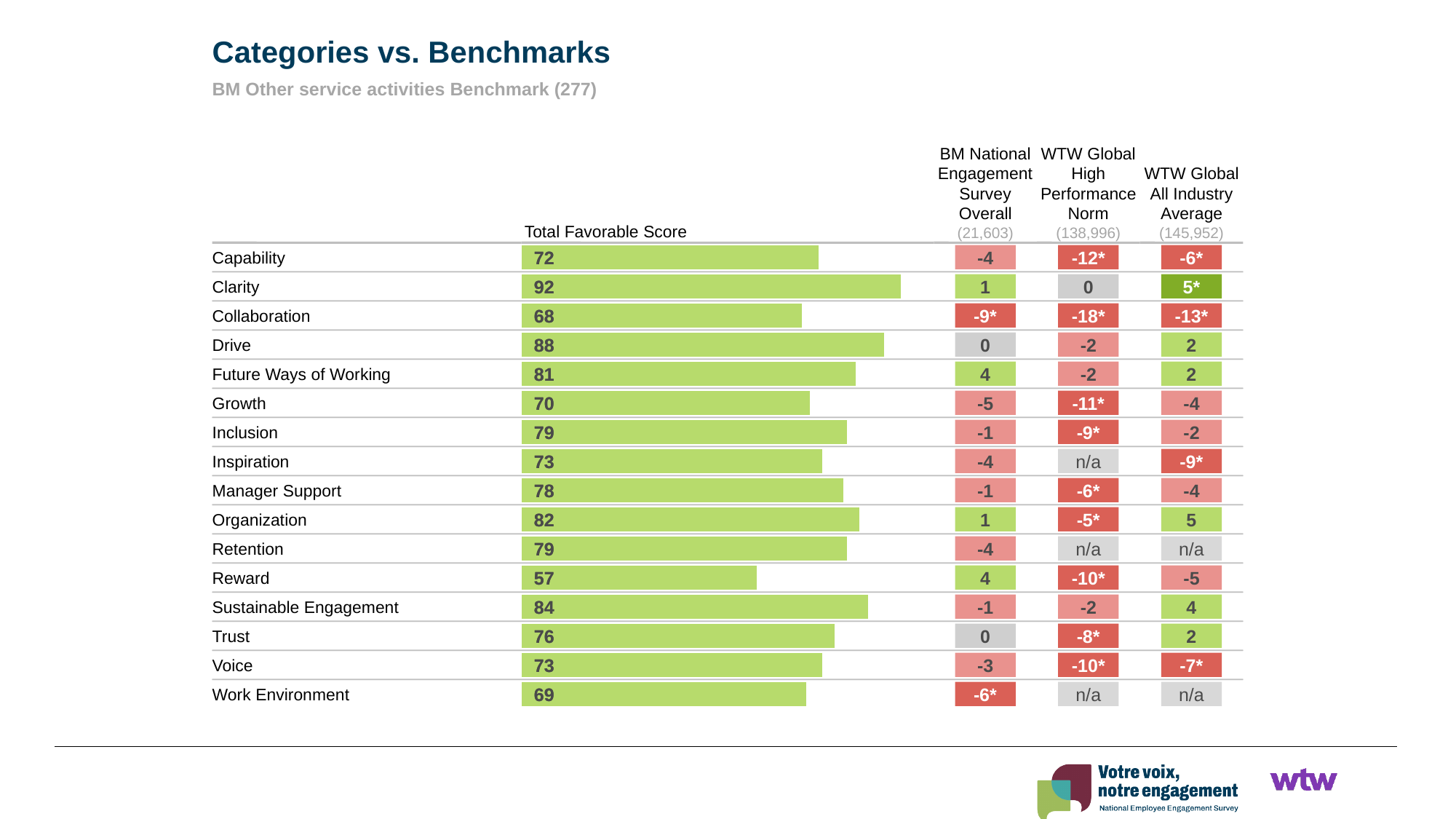
What is the difference versus the WTW Global High Performance Norm for Collaboration? -18* What is the title of the slide? Categories vs. Benchmarks What is the difference versus the BM National Engagement Survey Overall for Work Environment? -6* What is the Total Favorable Score for Clarity? 92 What is the Total Favorable Score for Reward? 57 What kind of chart is used to show the Total Favorable Score? Bar chart Which has a higher Total Favorable Score, Inclusion or Trust? Inclusion What is the difference between the Total Favorable Scores for Drive and Collaboration? 20 What is the difference versus the WTW Global All Industry Average for Organization? 5 How many categories are shown in the chart? 16 Which category has the lowest Total Favorable Score? Reward Which category has the highest Total Favorable Score? Clarity